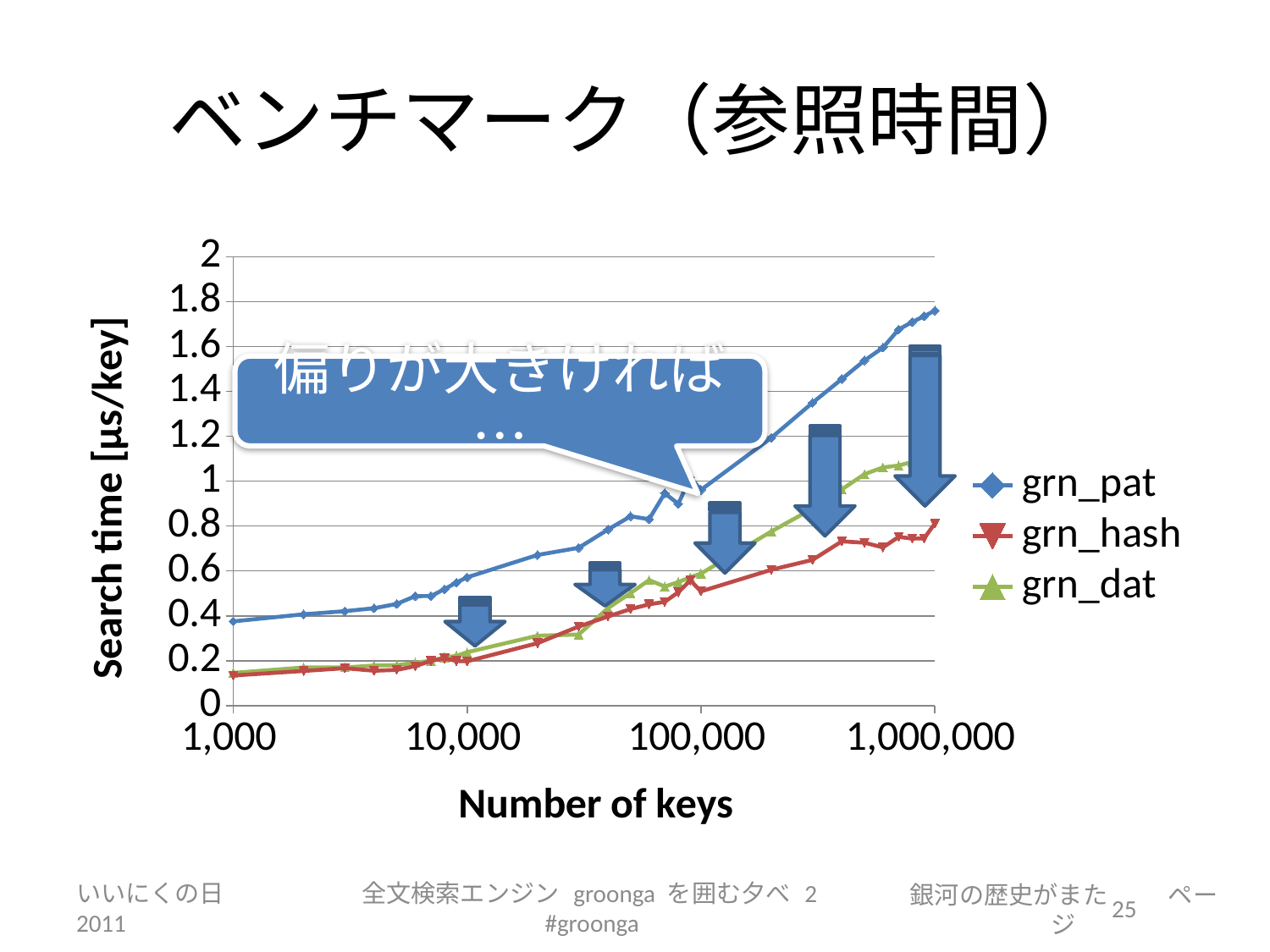
How many series does the legend list? 3 At 1,000,000 keys, which series has the larger search time, grn_pat or grn_hash? grn_pat Is the search time for grn_hash at 1,000,000 keys greater or less than 1? less What kind of chart is shown on the slide? line chart What are the series names listed in the legend? grn_pat, grn_hash, grn_dat Is the search time for grn_pat at 1,000,000 keys greater or less than 1.6? greater What is the title of the vertical axis? Search time [µs/key] Does the search time for grn_pat rise or fall as the number of keys increases? rise At 100,000 keys, which series has the larger search time, grn_pat or grn_dat? grn_pat Is the search time for grn_pat at 1,000 keys greater or less than 0.2? greater Which series has the highest search time at 1,000,000 keys? grn_pat Which series has the lowest search time at 1,000,000 keys? grn_hash